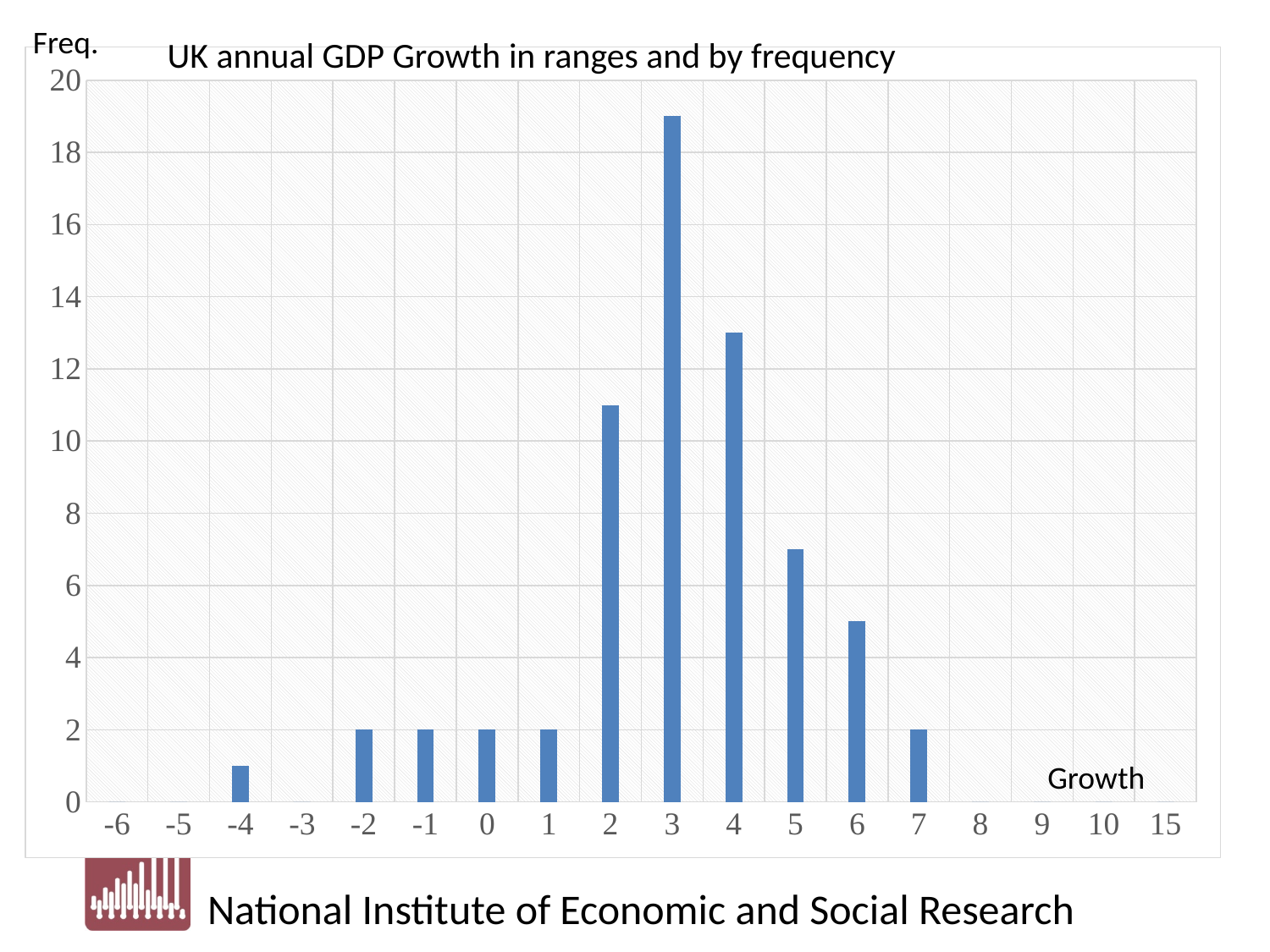
Is the frequency for the growth range 3 greater or less than 18? greater What type of chart is shown on the slide? bar chart Among the growth ranges with a visible bar, which has the lowest frequency? -4 What is the frequency for the growth range 7? 2 How many growth ranges are labelled on the x axis? 18 What is the title of the chart? UK annual GDP Growth in ranges and by frequency Which has a higher frequency, the growth range 2 or the growth range 4? 4 What is the frequency for the growth range -2? 2 Is the frequency for the growth range 4 greater or less than 12? greater Is the frequency for the growth range 5 greater or less than 8? less Which growth range has the highest frequency? 3 How many growth ranges have a visible bar? 11